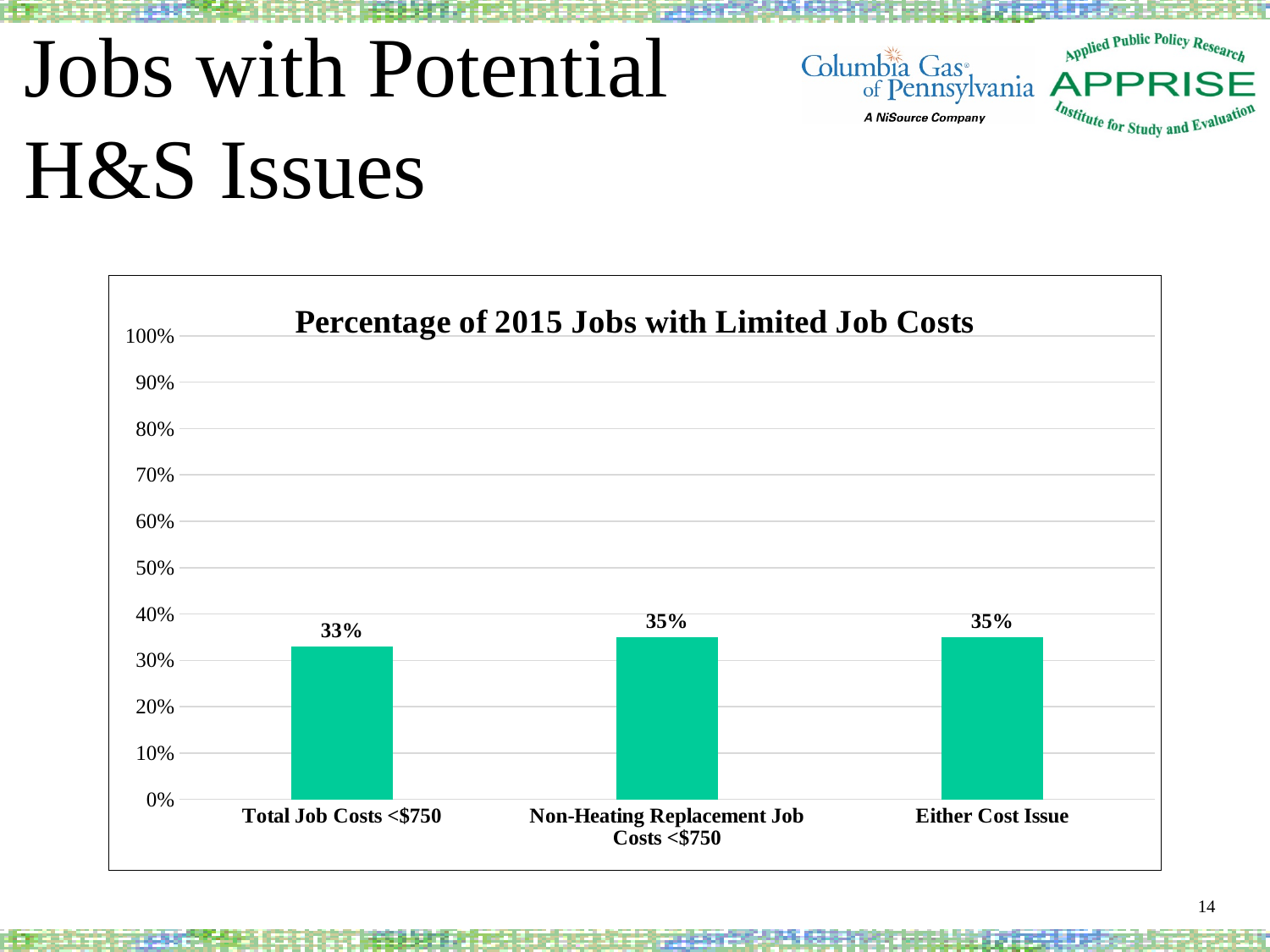
Which category has the lowest value? Total Job Costs <$750 Is the value for Total Job Costs <$750 greater or less than 30%? greater What is the highest value shown on the vertical axis? 100% What is the difference between the values for Either Cost Issue and Total Job Costs <$750? 2% Which is larger, the value for Total Job Costs <$750 or the value for Non-Heating Replacement Job Costs <$750? Non-Heating Replacement Job Costs <$750 What is the value for Total Job Costs <$750? 33% What kind of chart is shown on the slide? bar chart How many categories are shown in the chart? 3 What is the title of the chart? Percentage of 2015 Jobs with Limited Job Costs What is the value for Either Cost Issue? 35% Is the value for Either Cost Issue greater or less than 50%? less What is the value for Non-Heating Replacement Job Costs <$750? 35%